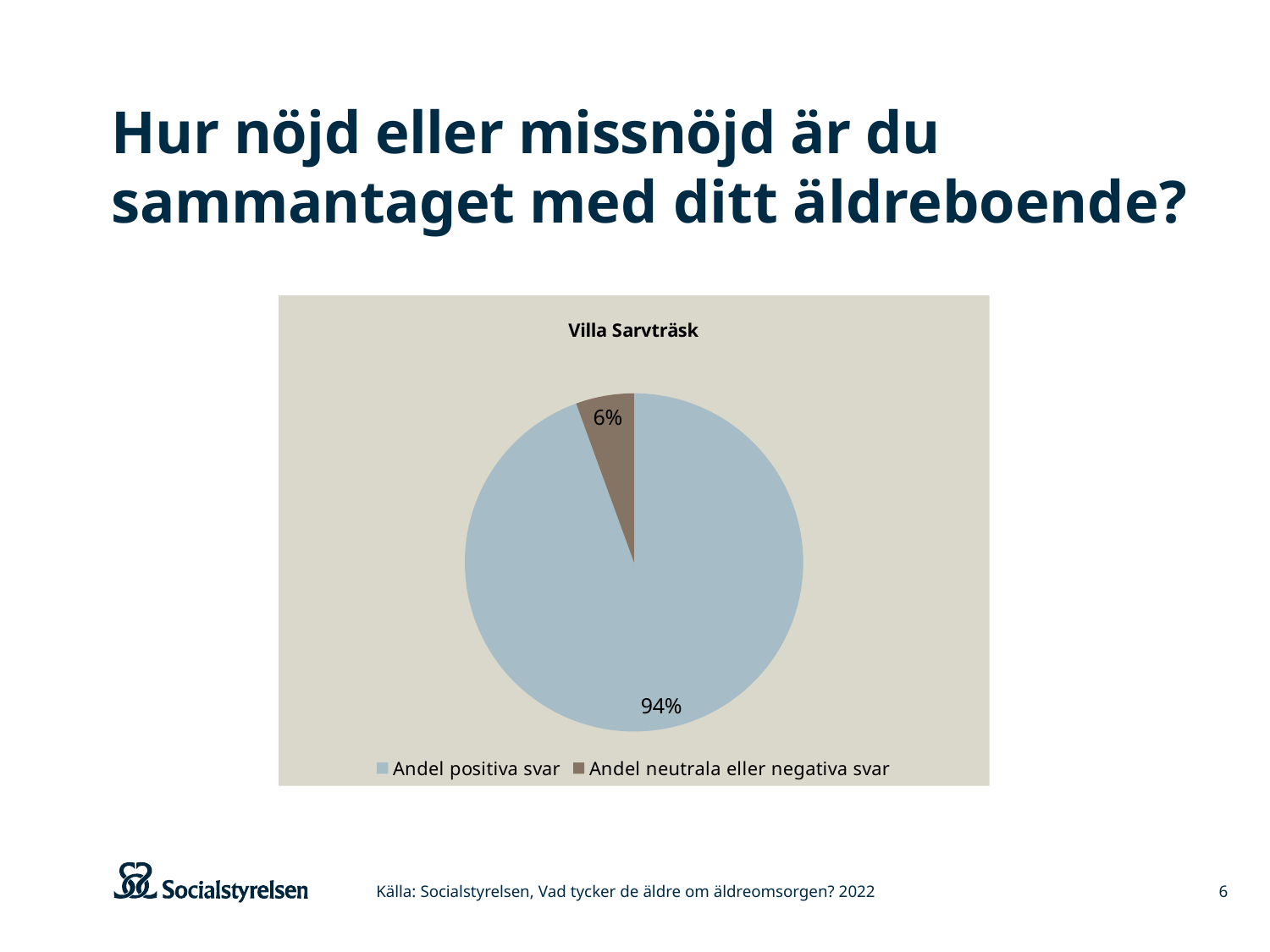
What is the difference between Andel positiva svar and Andel neutrala eller negativa svar? 88% Which slice is the smallest? Andel neutrala eller negativa svar What is the value for Andel positiva svar? 94% What is the value for Andel neutrala eller negativa svar? 6% What colour is the slice for Andel neutrala eller negativa svar? brown How many slices does the pie chart have? 2 Which is larger, Andel positiva svar or Andel neutrala eller negativa svar? Andel positiva svar What is the title of the chart? Villa Sarvträsk How many entries does the legend list? 2 What kind of chart is shown on the slide? pie chart Which slice is the largest? Andel positiva svar What share of the pie does Andel neutrala eller negativa svar represent? 6%